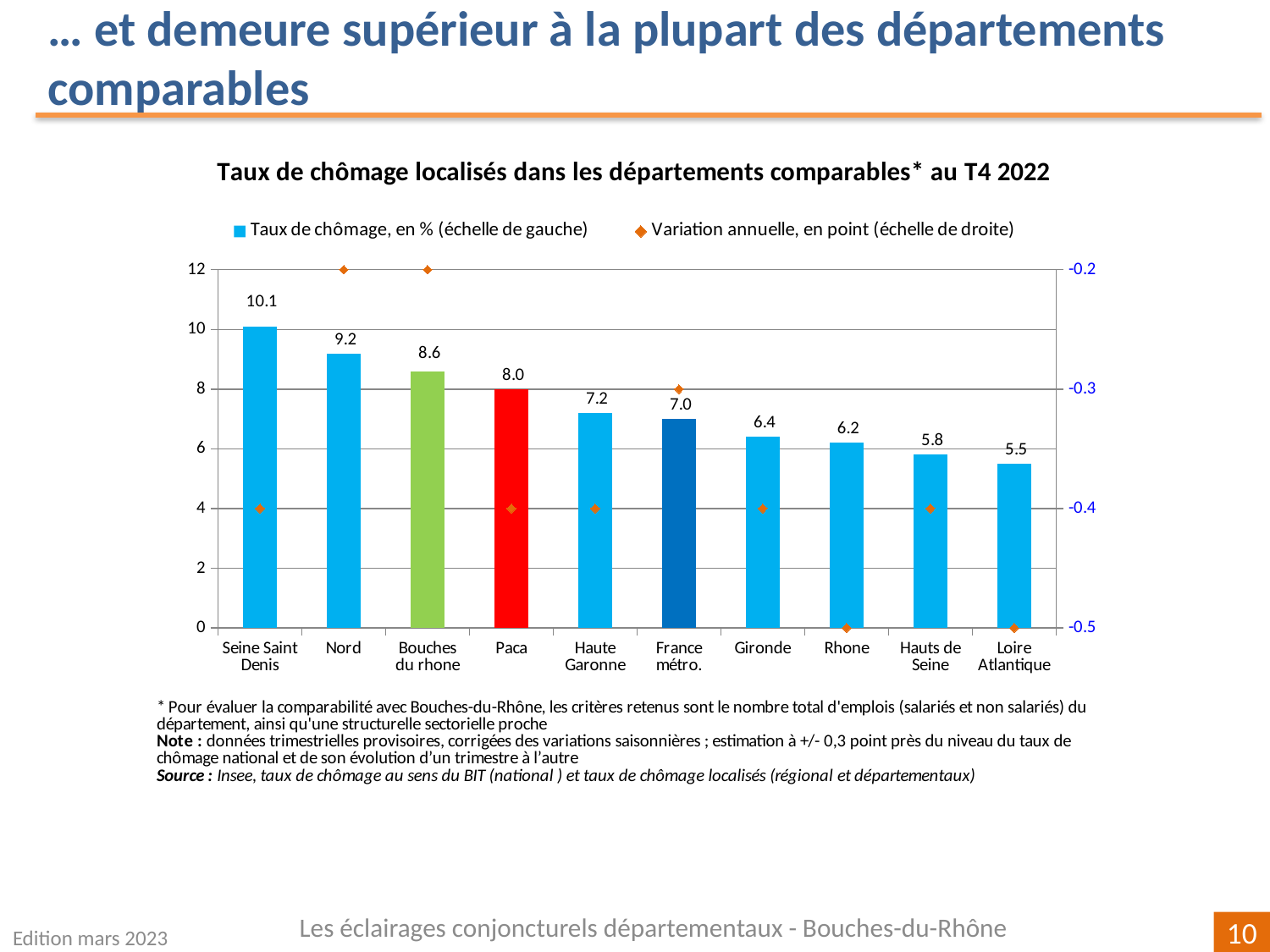
What is the annual variation (Variation annuelle) in points for Nord? -0.2 How many departments/categories are shown on the x axis? 10 What is the unemployment rate (Taux de chômage) for France métro.? 7.0 What is the unemployment rate (Taux de chômage) for Bouches du rhone? 8.6 What is the difference in unemployment rate between Bouches du rhone and Paca? 0.6 How many series does the legend list? 2 Which department has the lowest unemployment rate on the chart? Loire Atlantique Which has a higher unemployment rate, Nord or Gironde? Nord Which department has the highest unemployment rate on the chart? Seine Saint Denis What is the title of the chart? Taux de chômage localisés dans les départements comparables* au T4 2022 What is the unemployment rate (Taux de chômage) for Seine Saint Denis? 10.1 What is the annual variation (Variation annuelle) in points for Rhone? -0.5